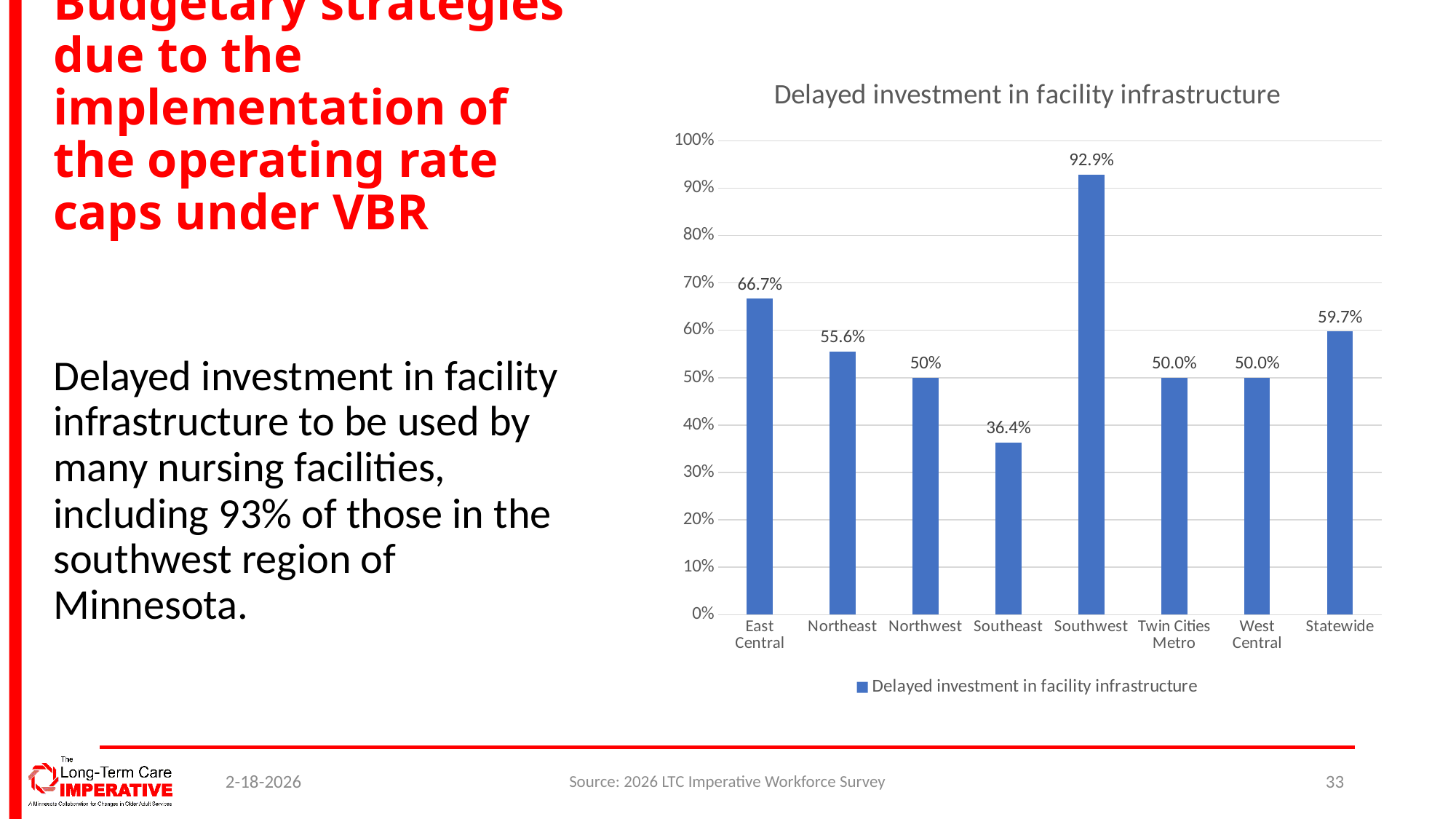
Is the value for Southeast greater or less than 40%? less What is the value for Southwest in the chart? 92.9% Which region has the lowest value in the chart? Southeast How many series does the chart legend list? 1 What is the difference between the Southwest and Southeast values? 56.5% What is the value for East Central in the chart? 66.7% What is the Statewide value in the chart? 59.7% Which region has the highest value in the chart? Southwest What is the title of the chart? Delayed investment in facility infrastructure Which is larger, the value for Northeast or the value for Northwest? Northeast How many categories are shown on the x axis of the chart? 8 What kind of chart is shown on the slide? bar chart